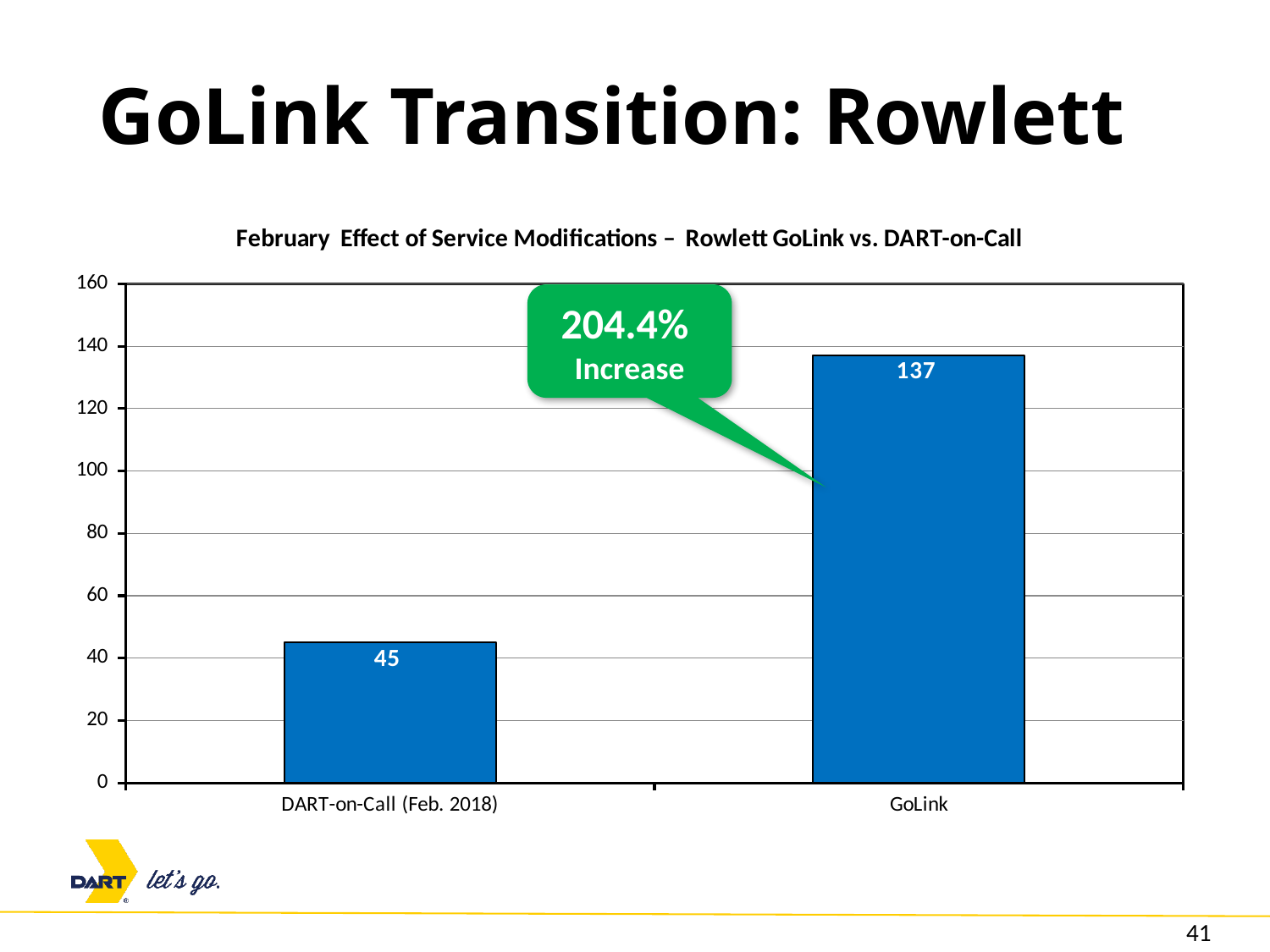
What percentage increase does the callout on the chart state? 204.4% Which category has the highest value? GoLink Which is larger, the value for GoLink or the value for DART-on-Call (Feb. 2018)? GoLink Is the value for DART-on-Call (Feb. 2018) greater or less than 60? less How many categories are shown on the x axis? 2 What kind of chart is shown on the slide? Bar chart What is the difference between the GoLink value and the DART-on-Call (Feb. 2018) value? 92 What is the value for DART-on-Call (Feb. 2018)? 45 Which category has the lowest value? DART-on-Call (Feb. 2018) Is the value for GoLink greater or less than 120? greater What is the title of the chart? February Effect of Service Modifications – Rowlett GoLink vs. DART-on-Call What is the value for GoLink? 137